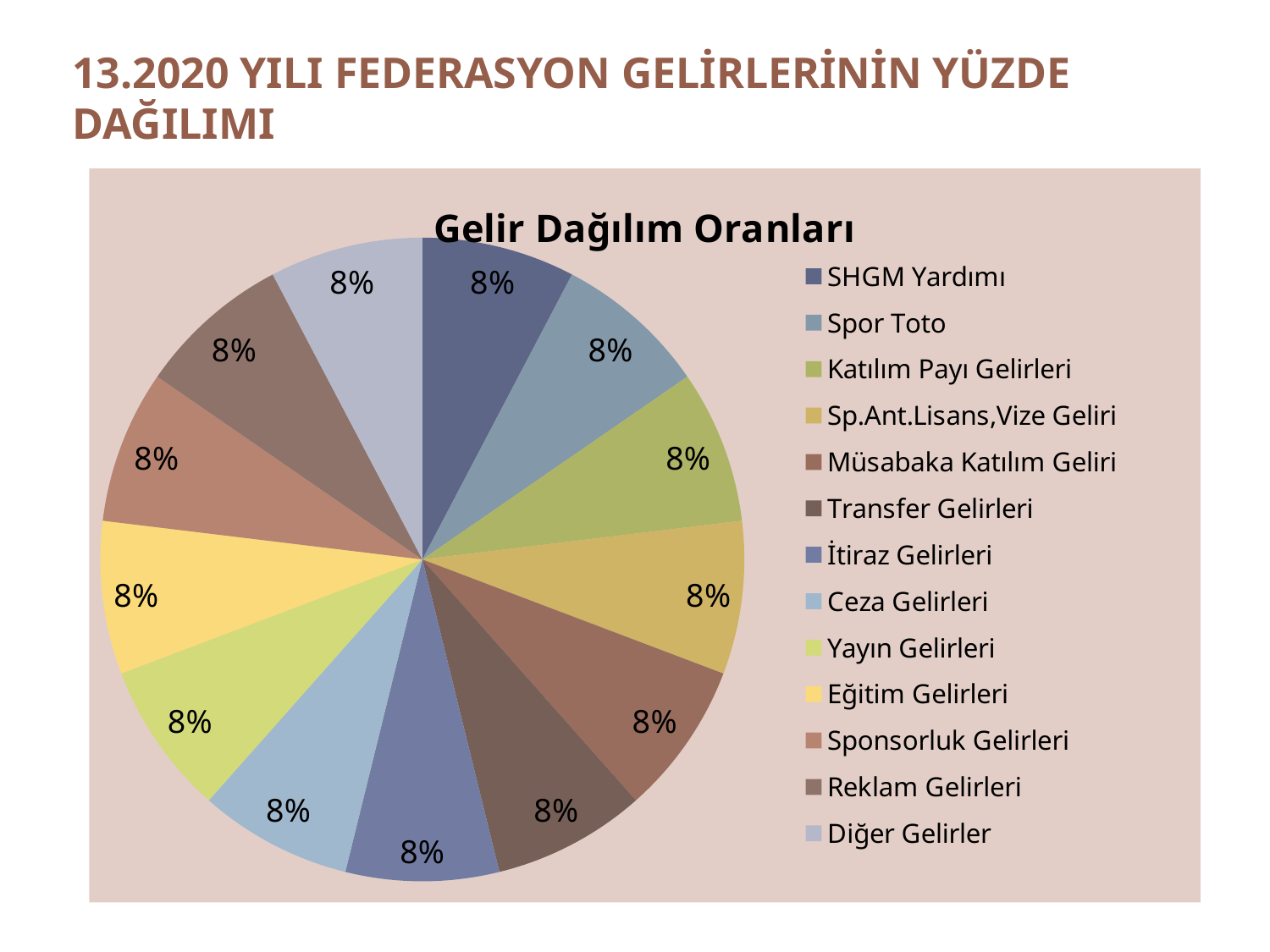
What percentage is shown for Diğer Gelirler? 8% How many slices does the pie chart have? 13 What is the difference between the shares of Reklam Gelirleri and Yayın Gelirleri? 0% What percentage is shown for Transfer Gelirleri? 8% What percentage is shown for Eğitim Gelirleri? 8% Which legend entry is listed first? SHGM Yardımı What share of the pie is labelled for SHGM Yardımı? 8% What is the title of the chart? Gelir Dağılım Oranları What kind of chart is shown on the slide? pie chart What is the combined share of Sponsorluk Gelirleri and Ceza Gelirleri? 16% How many entries does the legend list? 13 What share of the pie is labelled for Spor Toto? 8%